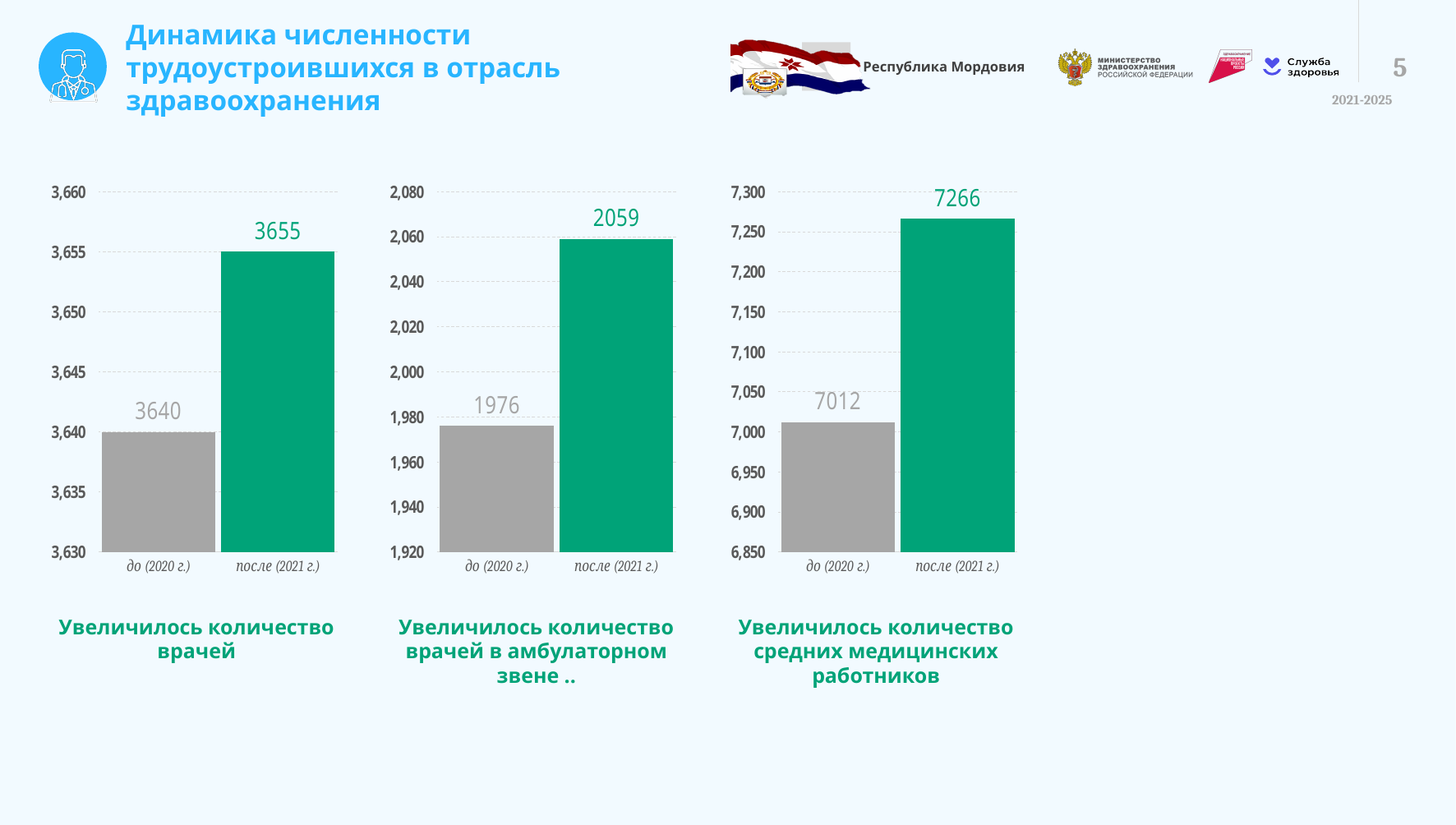
In the left chart (врачей), what is the difference between the после (2021 г.) and до (2020 г.) values? 15 In the right chart (средних медицинских работников), what is the value for после (2021 г.)? 7266 What type of chart is the left chart (врачей)? bar chart In the right chart (средних медицинских работников), what is the value for до (2020 г.)? 7012 How many categories are shown in the middle chart (врачей в амбулаторном звене)? 2 In the left chart (врачей), what is the value for после (2021 г.)? 3655 In the right chart (средних медицинских работников), which category has the lowest value? до (2020 г.) In the left chart (врачей), what is the value for до (2020 г.)? 3640 In the middle chart (врачей в амбулаторном звене), what is the difference between the после (2021 г.) and до (2020 г.) values? 83 In the middle chart (врачей в амбулаторном звене), which category has the higher value? после (2021 г.) In the middle chart (врачей в амбулаторном звене), what is the value for после (2021 г.)? 2059 In the right chart (средних медицинских работников), what is the difference between the после (2021 г.) and до (2020 г.) values? 254